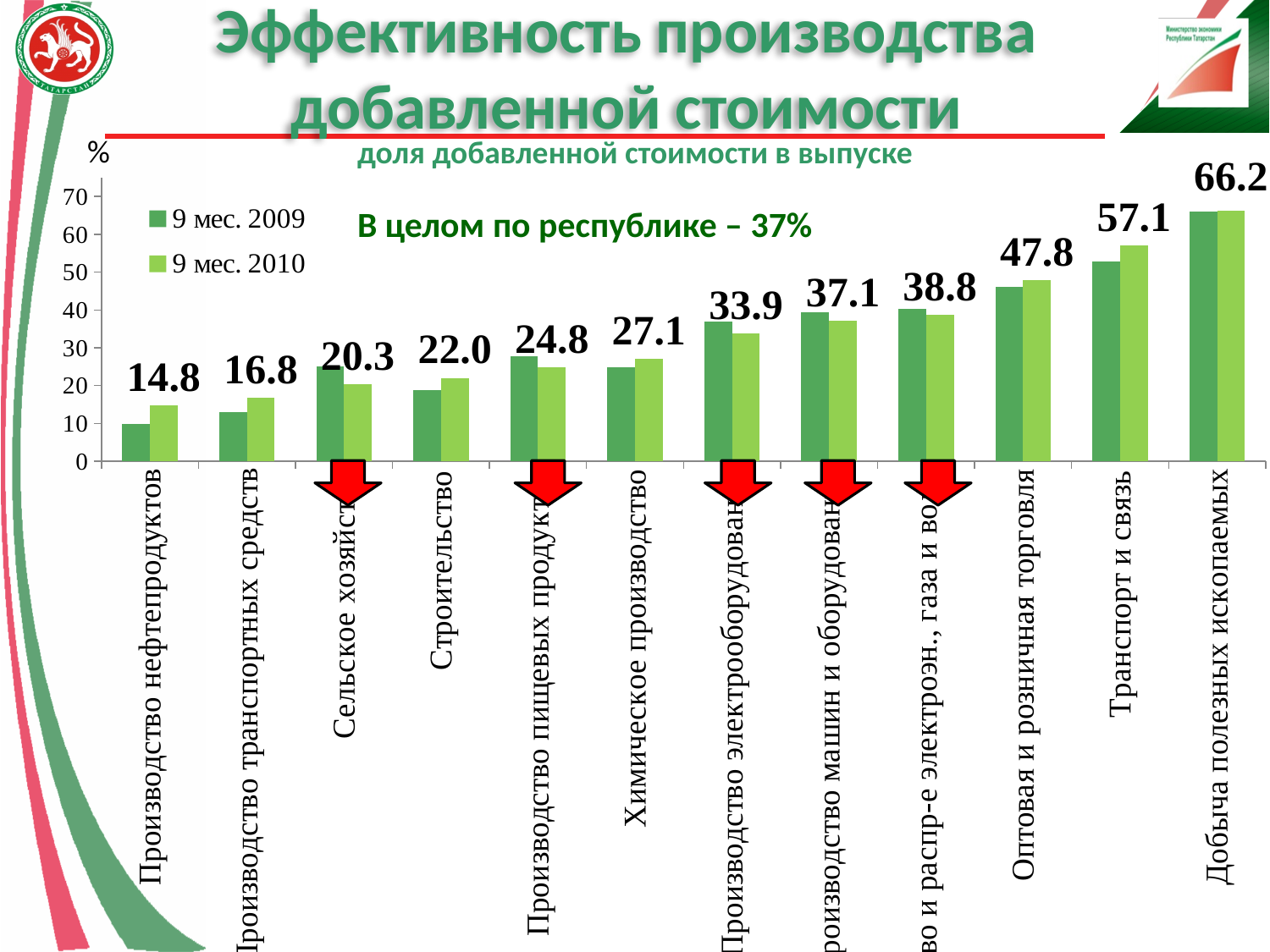
According to the text on the chart, what is the overall share for the republic (В целом по республике)? 37% What value is labelled for Добыча полезных ископаемых? 66.2 Which has the larger labelled value, Химическое производство or Строительство? Химическое производство Which category has the highest labelled value? Добыча полезных ископаемых Which category has the lowest labelled value? Производство нефтепродуктов What value is labelled for Транспорт и связь? 57.1 Is the 9 мес. 2009 value for Оптовая и розничная торговля greater or less than 50? less What value is labelled for Строительство? 22.0 How many categories are shown on the x axis of the chart? 12 What is the difference between the labelled values for Добыча полезных ископаемых and Транспорт и связь? 9.1 What type of chart is shown on the slide? bar chart How many series does the legend list? 2